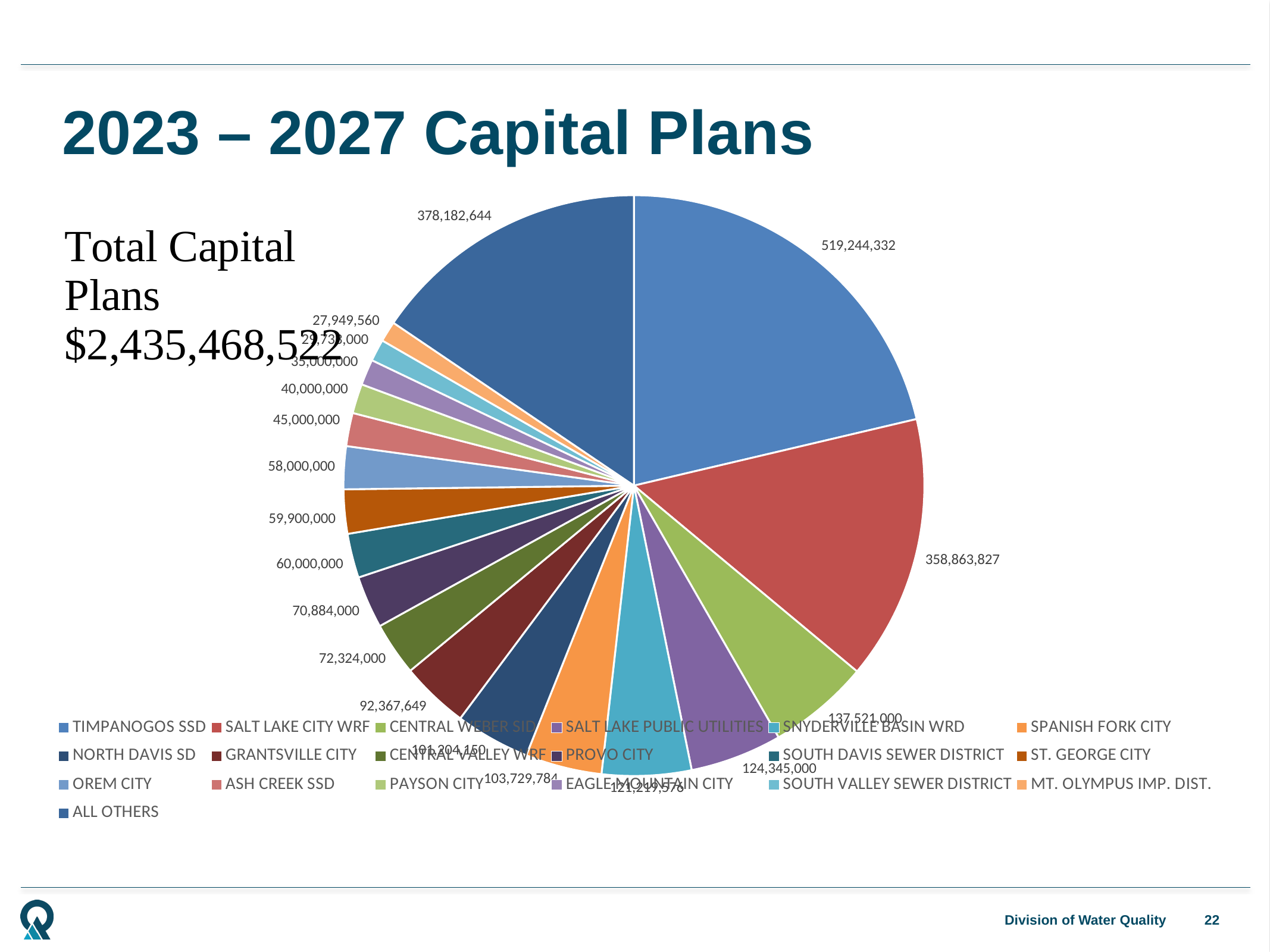
What is the difference between the values for TIMPANOGOS SSD and SALT LAKE CITY WRF? 160,380,505 What is the value for TIMPANOGOS SSD? 519,244,332 What is the value for SALT LAKE CITY WRF? 358,863,827 What is the value for ALL OTHERS? 378,182,644 Which category has the largest slice of the pie? TIMPANOGOS SSD What kind of chart is shown on the slide? pie chart Which is larger, the value for ALL OTHERS or the value for SALT LAKE CITY WRF? ALL OTHERS What total capital plans amount is stated on the slide? $2,435,468,522 What is the value for OREM CITY? 58,000,000 What is the value for GRANTSVILLE CITY? 92,367,649 How many categories does the legend of the pie chart list? 19 Which category has the smallest slice of the pie? MT. OLYMPUS IMP. DIST.